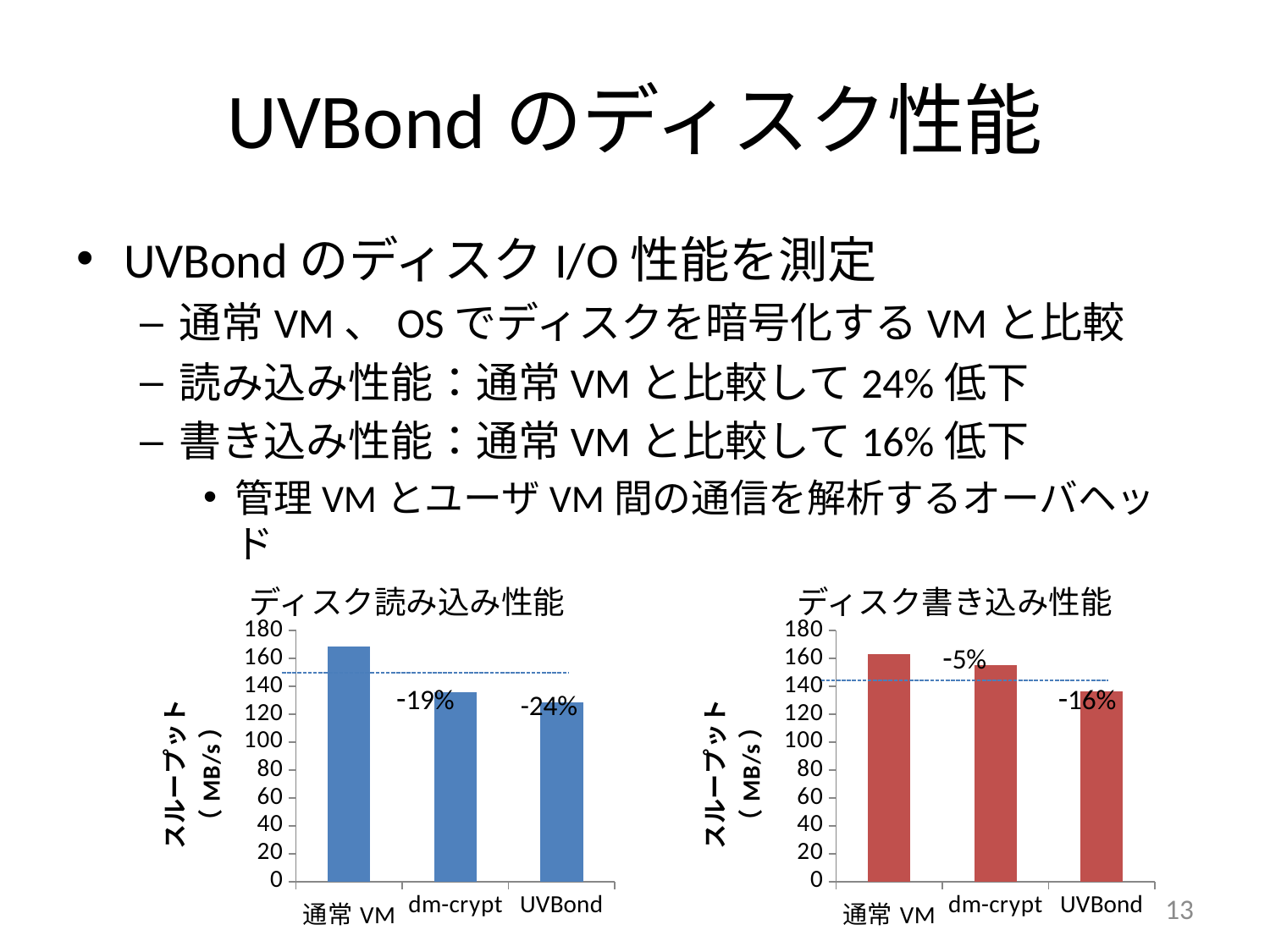
In the ディスク書き込み性能 chart on the right, what is the y-axis label? スループット（MB/s） In the ディスク読み込み性能 chart on the left, is the value for UVBond greater or less than 140? less In the ディスク書き込み性能 chart on the right, do the values rise or fall from 通常 VM to UVBond along the x axis? fall In the ディスク読み込み性能 chart on the left, what kind of chart is shown? bar chart In the ディスク書き込み性能 chart on the right, is the value for dm-crypt greater or less than 140? greater In the ディスク書き込み性能 chart on the right, which is larger, the value for 通常 VM or the value for UVBond? 通常 VM In the ディスク読み込み性能 chart on the left, is the value for 通常 VM greater or less than 160? greater In the ディスク読み込み性能 chart on the left, what percentage label is printed next to the UVBond bar? -24% In the ディスク読み込み性能 chart on the left, how many categories are plotted? 3 In the ディスク書き込み性能 chart on the right, which category has the lowest throughput? UVBond In the ディスク読み込み性能 chart on the left, which category has the highest throughput? 通常 VM